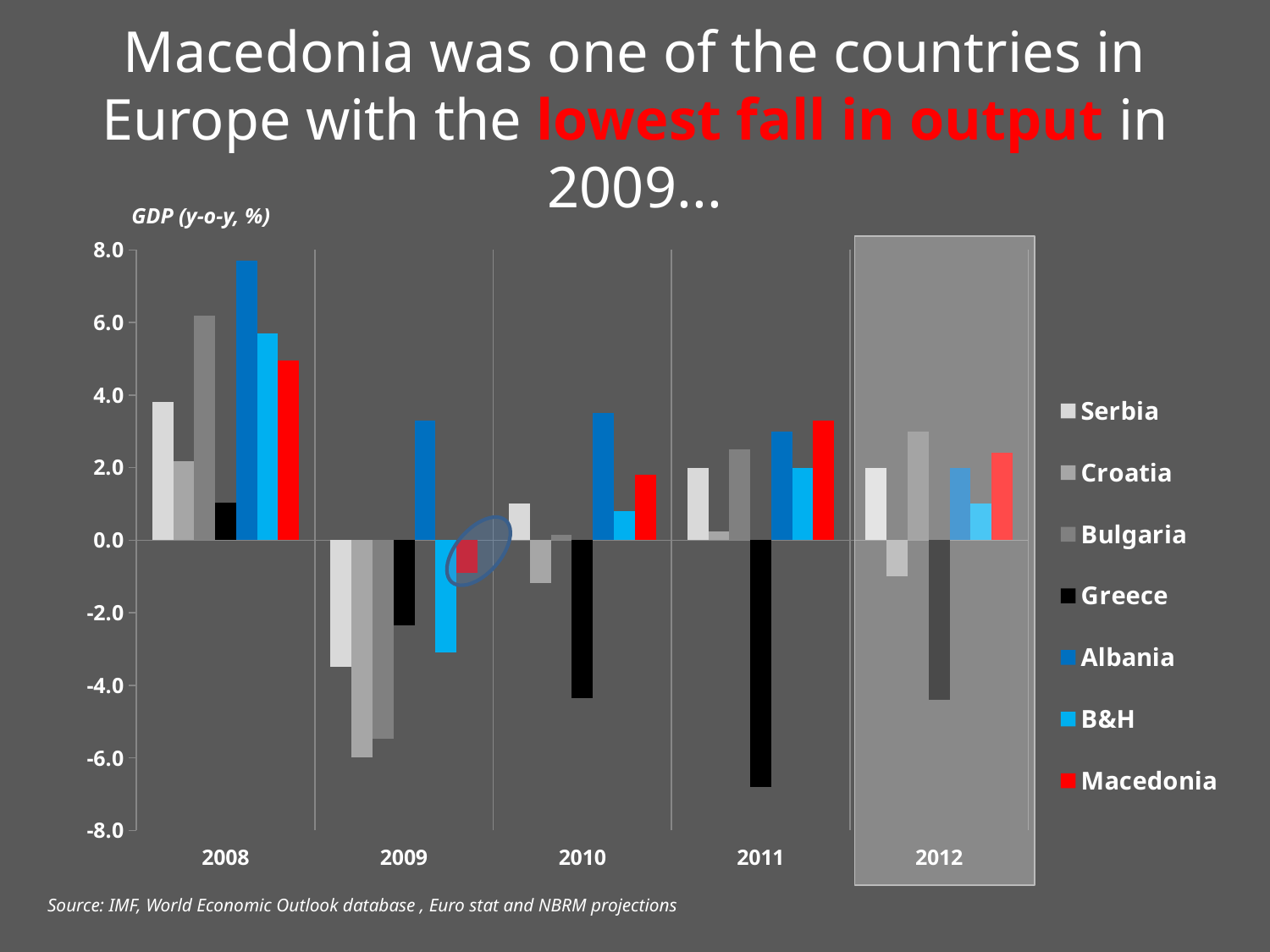
What kind of chart is shown on the slide? bar chart Which country is shown in red in the legend? Macedonia Which country has the highest GDP growth in 2008? Albania Is the value for Albania in 2008 greater or less than 6.0? greater How many countries does the legend list? 7 Which country has the lowest GDP growth in 2011? Greece Is the value for Macedonia in 2008 greater or less than 4.0? greater Which is larger in 2008, the value for Albania or the value for Macedonia? Albania Is the value for Serbia in 2009 greater or less than -2.0? less How many years are shown along the x axis? 5 What is the axis label shown above the chart? GDP (y-o-y, %)